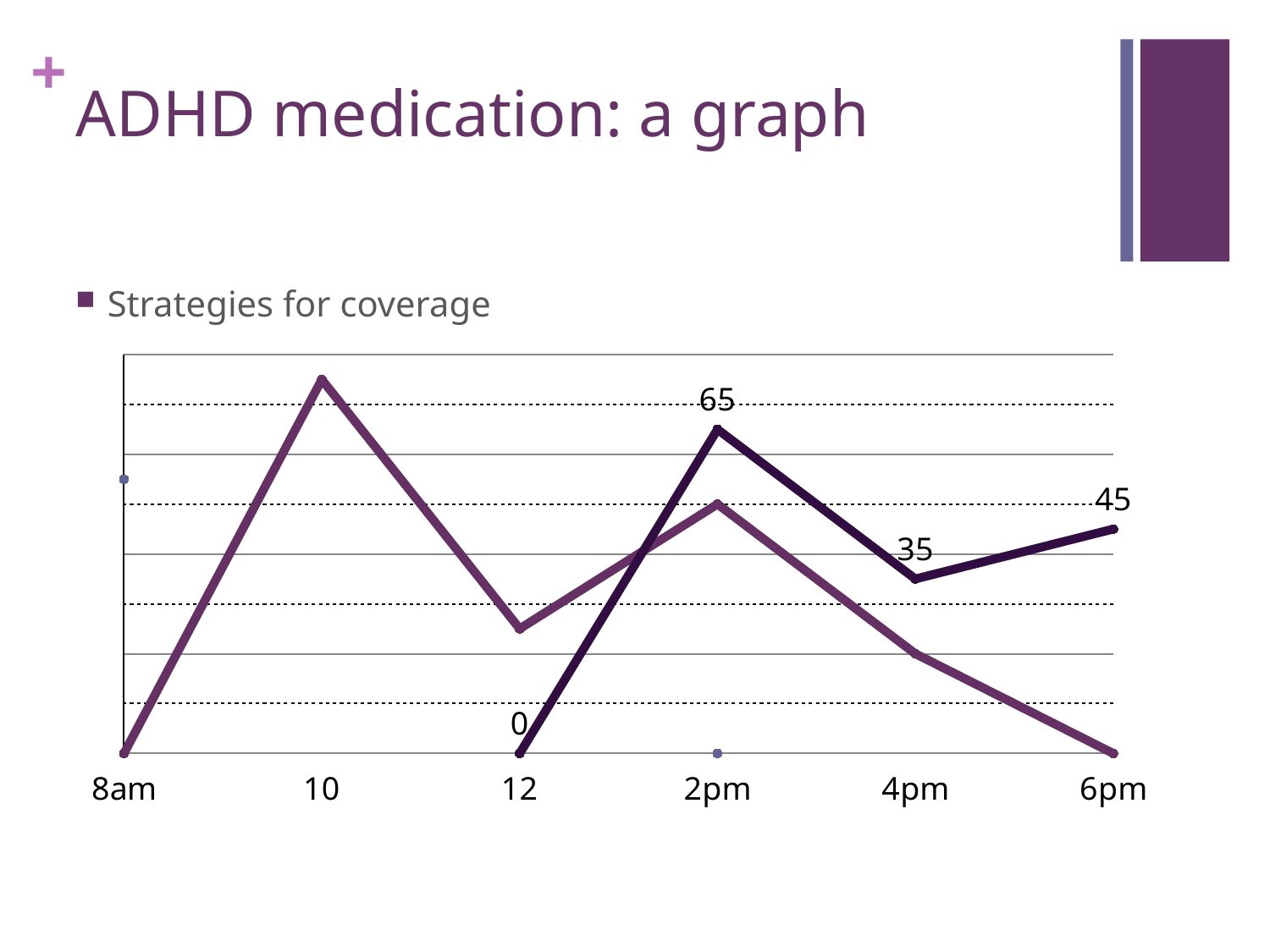
At which time does the lighter purple line reach its highest value? 10 How many time points are labelled along the x axis? 6 At which time does the darker purple line reach its highest value? 2pm Which is larger for the darker purple line: the value at 4pm or the value at 6pm? 6pm What is the value of the darker purple line at 6pm? 45 What is the value of the darker purple line at 4pm? 35 How many lines are plotted on the chart? 2 What is the value of the darker purple line at 12? 0 What is the value of the darker purple line at 2pm? 65 What kind of chart is shown on the slide? line chart What is the difference between the darker purple line's values at 2pm and 4pm? 30 Does the darker purple line rise or fall between 2pm and 4pm? fall